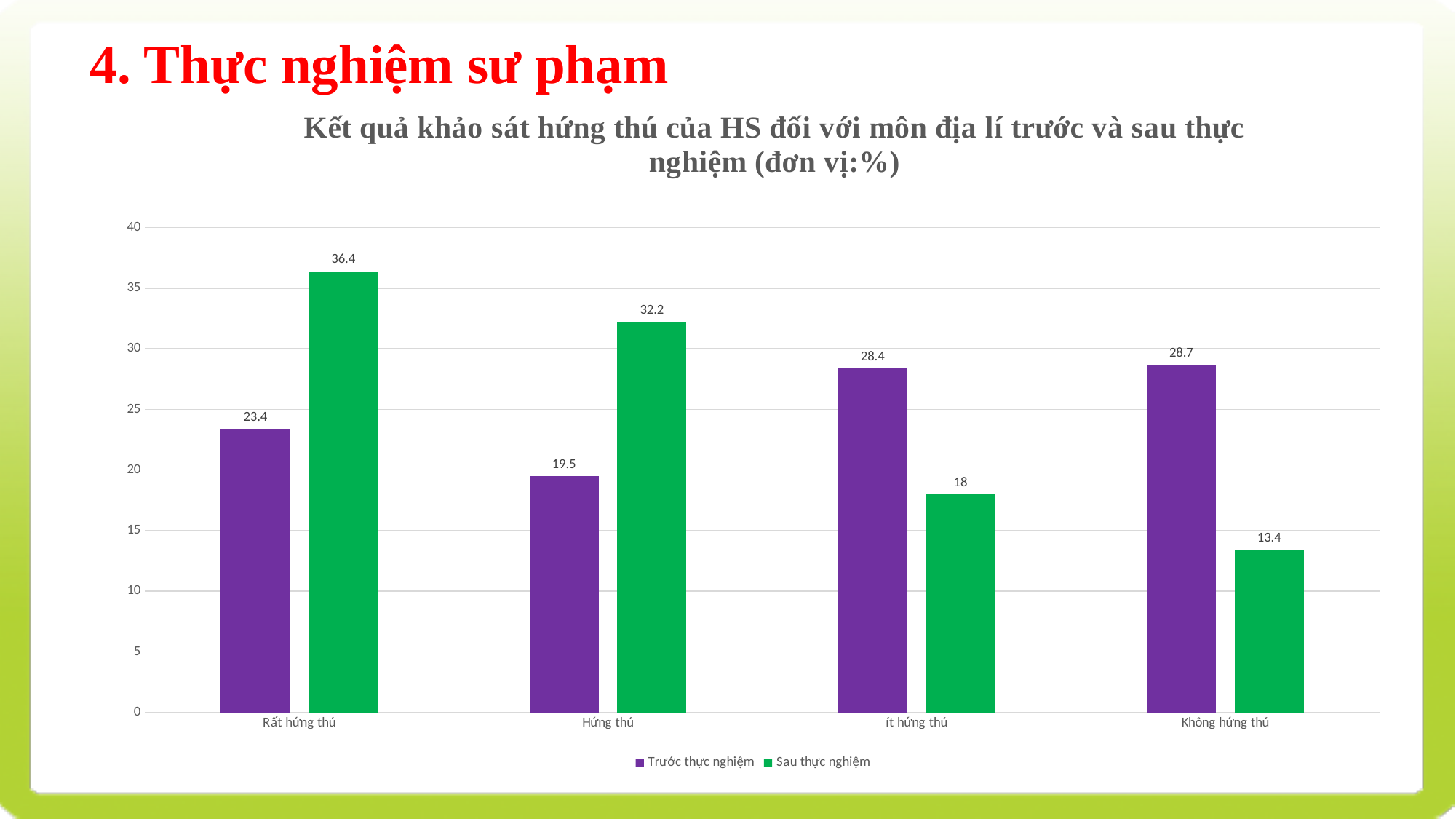
Which category has the lowest value in the "Trước thực nghiệm" series? Hứng thú Which is larger for "ít hứng thú": the "Trước thực nghiệm" value or the "Sau thực nghiệm" value? Trước thực nghiệm How many series does the legend list? 2 What is the value for "Hứng thú" in the "Sau thực nghiệm" series? 32.2 How many categories are shown on the x axis? 4 Which category has the highest value in the "Sau thực nghiệm" series? Rất hứng thú What is the difference between the "Sau thực nghiệm" and "Trước thực nghiệm" values for "Rất hứng thú"? 13 Is the "Sau thực nghiệm" value for "Hứng thú" greater or less than 30? greater What is the value for "Không hứng thú" in the "Sau thực nghiệm" series? 13.4 What is the value for "Rất hứng thú" in the "Trước thực nghiệm" series? 23.4 Which colour represents the "Sau thực nghiệm" series? green What kind of chart is shown on the slide? bar chart